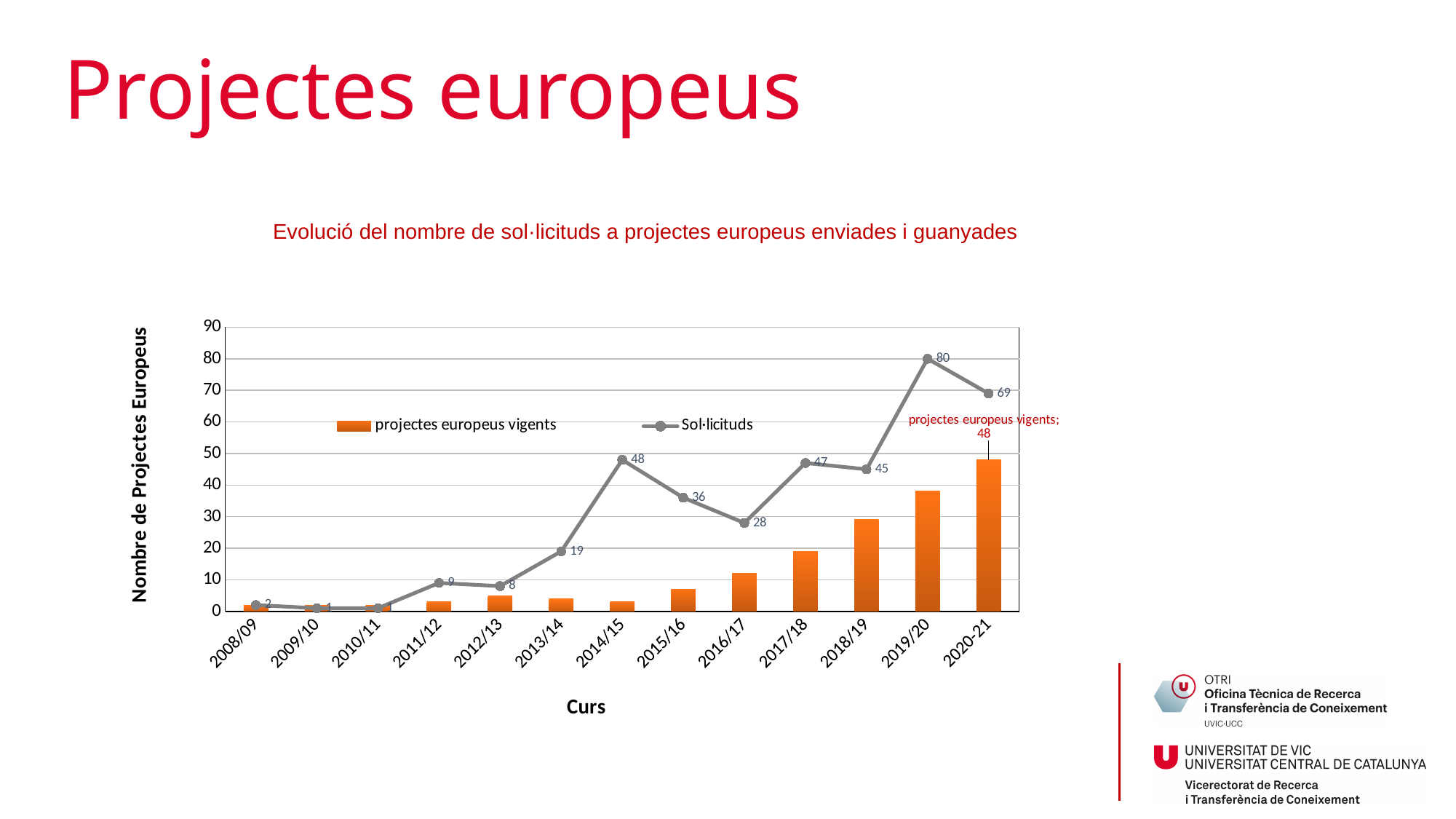
What is the difference in Sol·licituds between 2019/20 and 2020-21? 11 What is the value of projectes europeus vigents for 2020-21? 48 In which academic year is the number of Sol·licituds highest? 2019/20 What is the value of Sol·licituds for 2019/20? 80 Do the Sol·licituds values rise or fall from 2016/17 to 2019/20? Rise How many series does the legend list? 2 What is the value of Sol·licituds for 2014/15? 48 Is the value of projectes europeus vigents for 2018/19 greater or less than 20? greater Which year has more Sol·licituds, 2015/16 or 2016/17? 2015/16 Is the value of projectes europeus vigents for 2016/17 greater or less than 10? greater How many academic years are shown on the x axis? 13 What kind of chart is shown on the slide? Combined bar and line chart